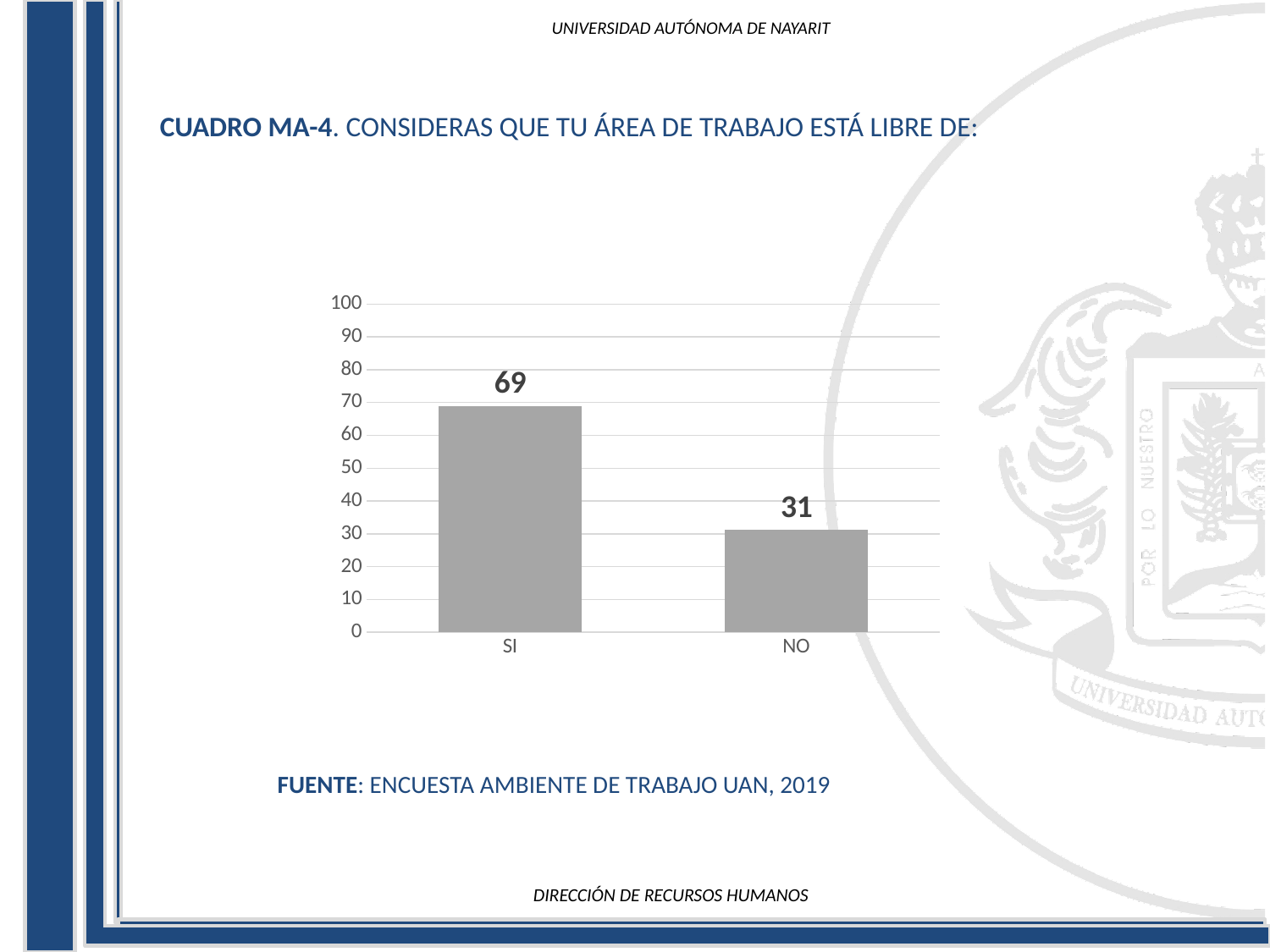
What is the total of the two bars? 100 What is the value for NO? 31 Is the value for NO greater or less than 40? less Is the value for SI greater or less than 60? greater What is the value for SI? 69 What is the difference between the values for SI and NO? 38 What kind of chart is shown on the slide? bar chart How many categories are shown on the x axis? 2 Which category has the highest value? SI Which category has the lowest value? NO What is the highest value shown on the y axis? 100 Which is larger, the value for SI or the value for NO? SI